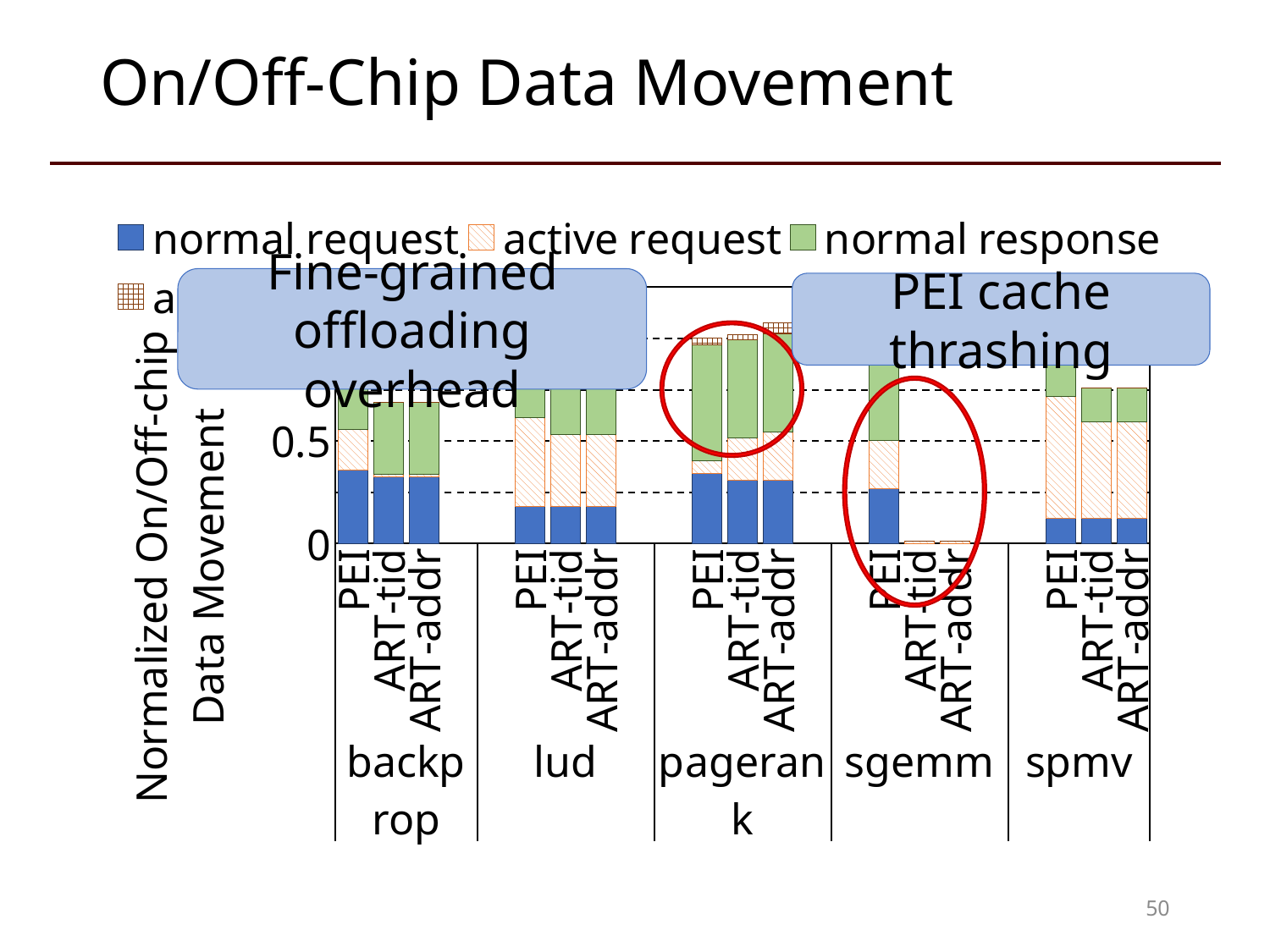
How many benchmark groups are shown along the x axis of the chart? 5 Which is taller in the sgemm group: the PEI bar or the ART-tid bar? PEI What is the label of the y axis of the chart? Normalized On/Off-chip Data Movement Is the normal request portion of the backprop PEI bar greater or less than 0.5? less What kind of chart is shown on the slide? stacked bar chart How many bars are plotted within each benchmark group on the chart? 3 Is the total height of the pagerank PEI bar greater or less than 0.5? greater Which is taller in the lud group: the PEI bar or the ART-tid bar? PEI Which benchmark group has the lowest ART-tid bar in the chart? sgemm Which benchmark group is circled with the annotation 'PEI cache thrashing'? sgemm Is the total height of the sgemm ART-addr bar greater or less than 0.5? less Which legend entry is drawn in solid blue? normal request